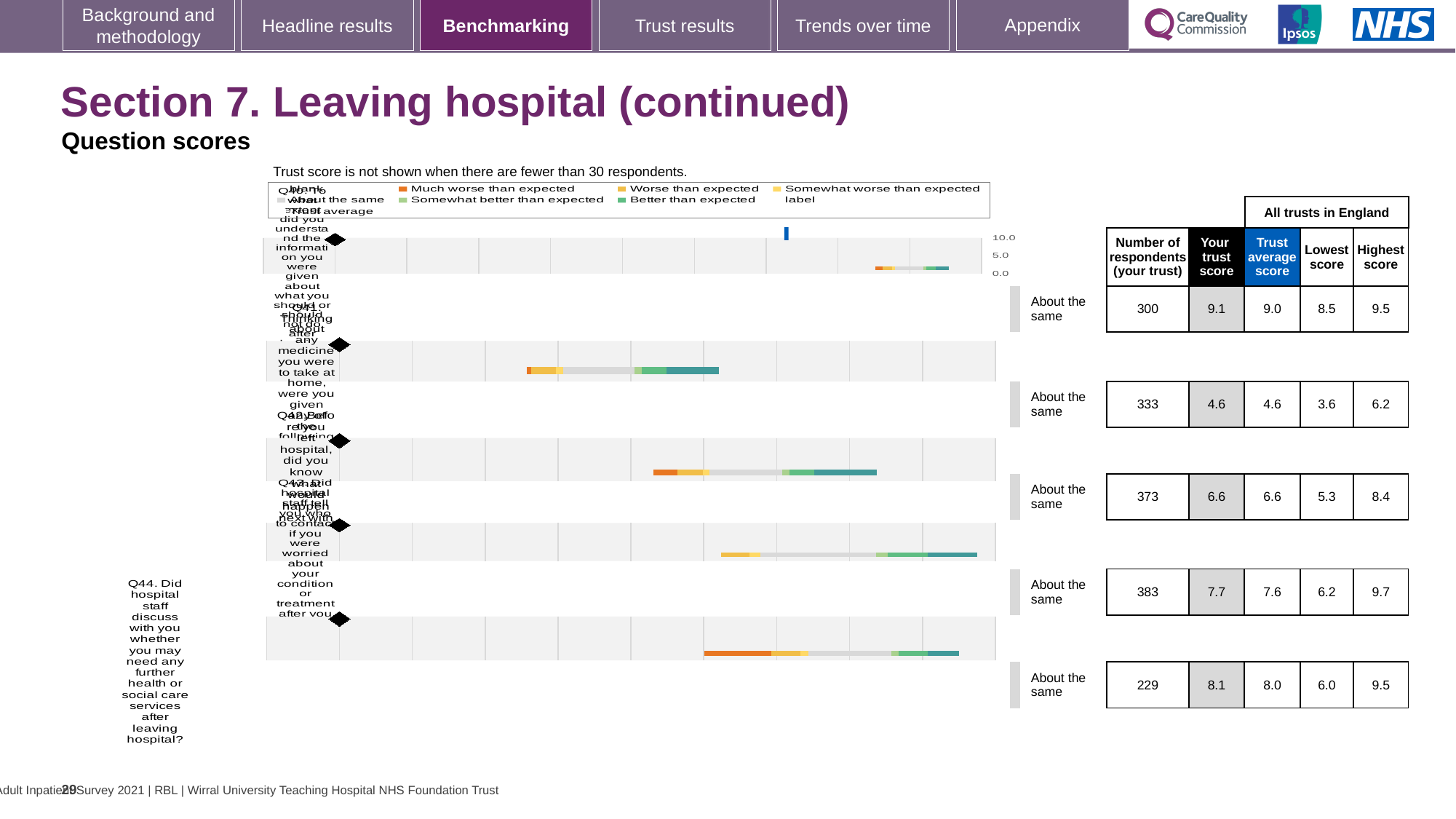
What is the 'Your trust score' for Q44 (Did hospital staff discuss with you whether you may need any further health or social care services after leaving hospital?)? 8.1 Which legend entry is shown in orange? Much worse than expected What comparison label is shown next to the Q44 row? About the same What is the lowest 'Your trust score' shown in the table? 4.6 Which question row has the largest number of respondents? The fourth row (383 respondents) How many respondents from your trust answered Q44? 229 How many question rows are shown in the benchmarking chart? 5 What is the trust average score for the first question row (300 respondents)? 9.0 What type of chart is used to show the benchmarking results? Bar chart What is the difference between the highest score (9.5) and the lowest score (6.0) for Q44? 3.5 For Q44, which is larger: your trust score or the trust average score? Your trust score (8.1) What is the highest score across all trusts in England for Q44? 9.5